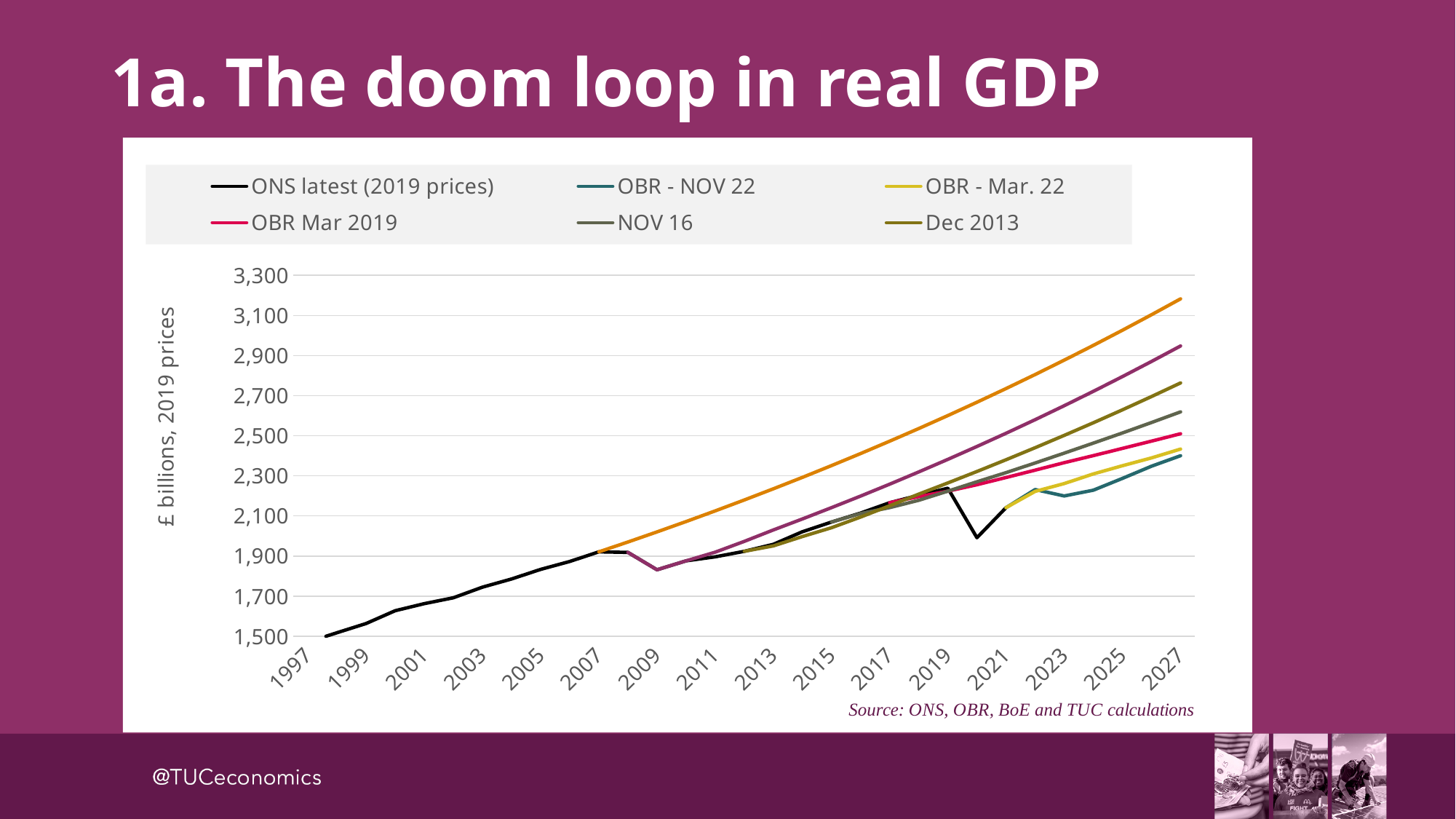
In 2027, which series is higher: NOV 16 or OBR Mar 2019? NOV 16 How many series does the legend list? 6 Is the value of the OBR Mar 2019 series in 2027 greater or less than 2,300? greater What is the label on the vertical axis? £ billions, 2019 prices Is the value of the ONS latest (2019 prices) series in 2007 greater or less than 1,700? greater Is the value of the ONS latest (2019 prices) series in 2020 greater or less than 2,100? less What kind of chart is shown on the slide? line chart What is the title of the slide? 1a. The doom loop in real GDP Does the ONS latest (2019 prices) series rise or fall between 1997 and 2007? rise In 2027, which series is higher: Dec 2013 or OBR - NOV 22? Dec 2013